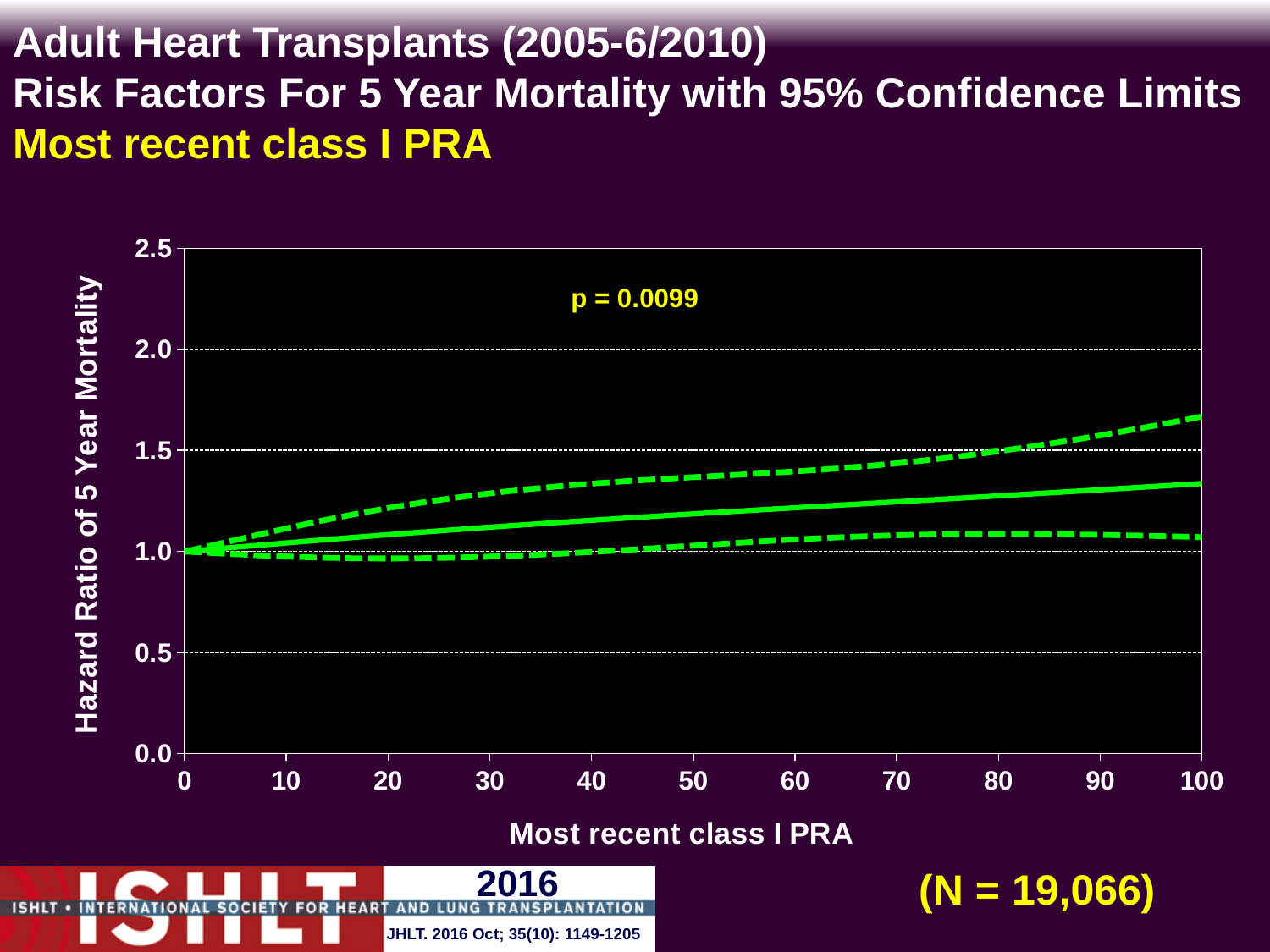
Is the upper 95% confidence limit (upper dashed line) at a Most recent class I PRA of 100 greater or less than 2.0? less Is the hazard ratio (solid line) at a Most recent class I PRA of 100 greater or less than 1.0? greater Is the hazard ratio (solid line) at a Most recent class I PRA of 100 greater or less than 1.5? less What is the label of the y-axis of the chart? Hazard Ratio of 5 Year Mortality What is the p-value printed on the chart? p = 0.0099 Does the solid hazard ratio line rise or fall as Most recent class I PRA increases from 0 to 100? rise How many tick marks are labelled on the x-axis of the chart? 11 What is the label of the x-axis of the chart? Most recent class I PRA What kind of chart is shown on the slide? line chart What is the sample size (N) shown on the slide? N = 19,066